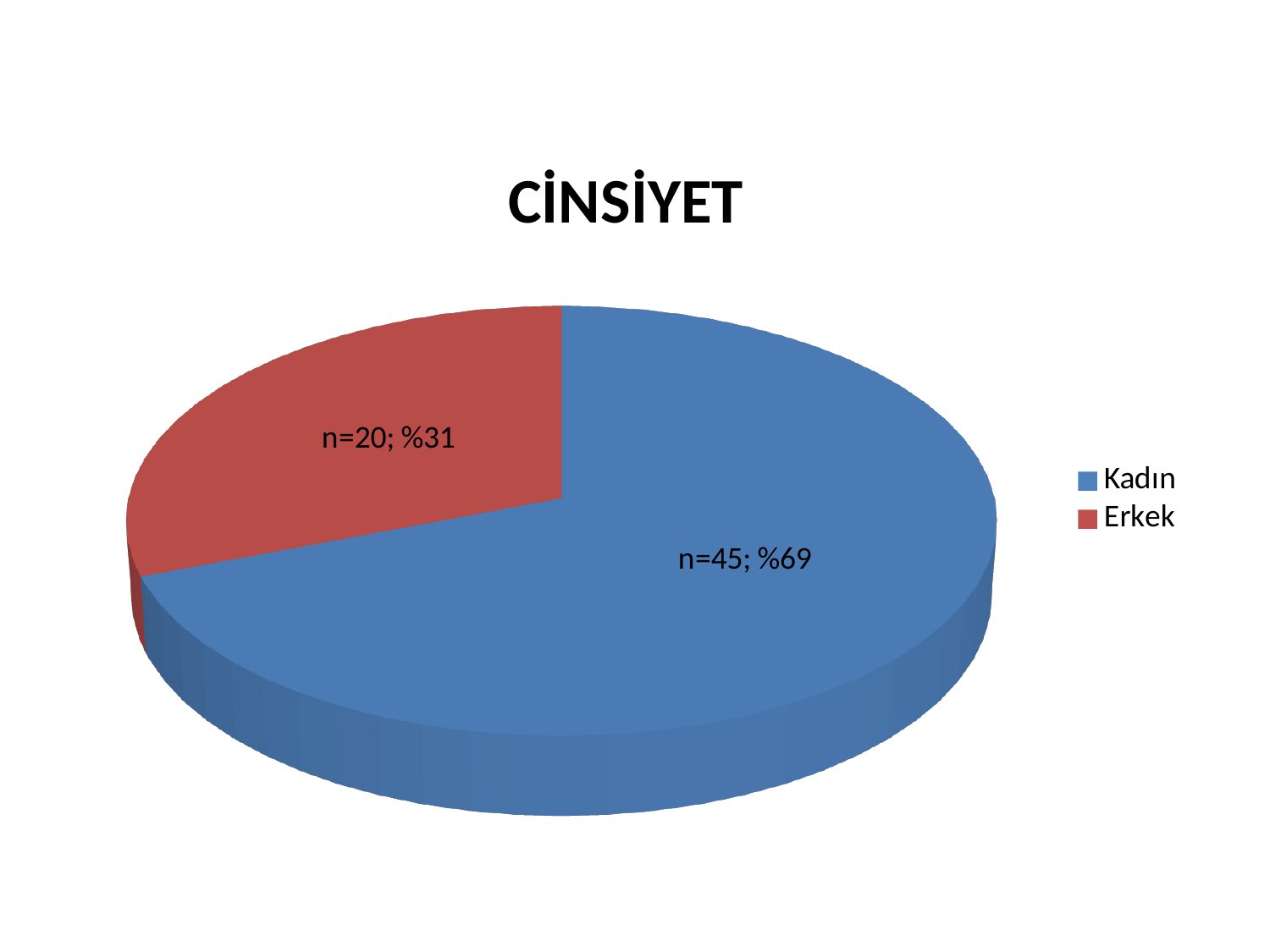
What kind of chart is shown on the slide? pie chart What is the count (n) for Kadın? n=45 Which category has the largest slice? Kadın How many slices does the pie chart have? 2 What is the title of the chart? CİNSİYET What percentage share of the pie does Erkek have? %31 How many entries does the legend list? 2 Which colour represents Erkek in the chart? red What percentage share of the pie does Kadın have? %69 What is the count (n) for Erkek? n=20 Which category has the smallest slice? Erkek What is the difference in count between Kadın and Erkek? 25